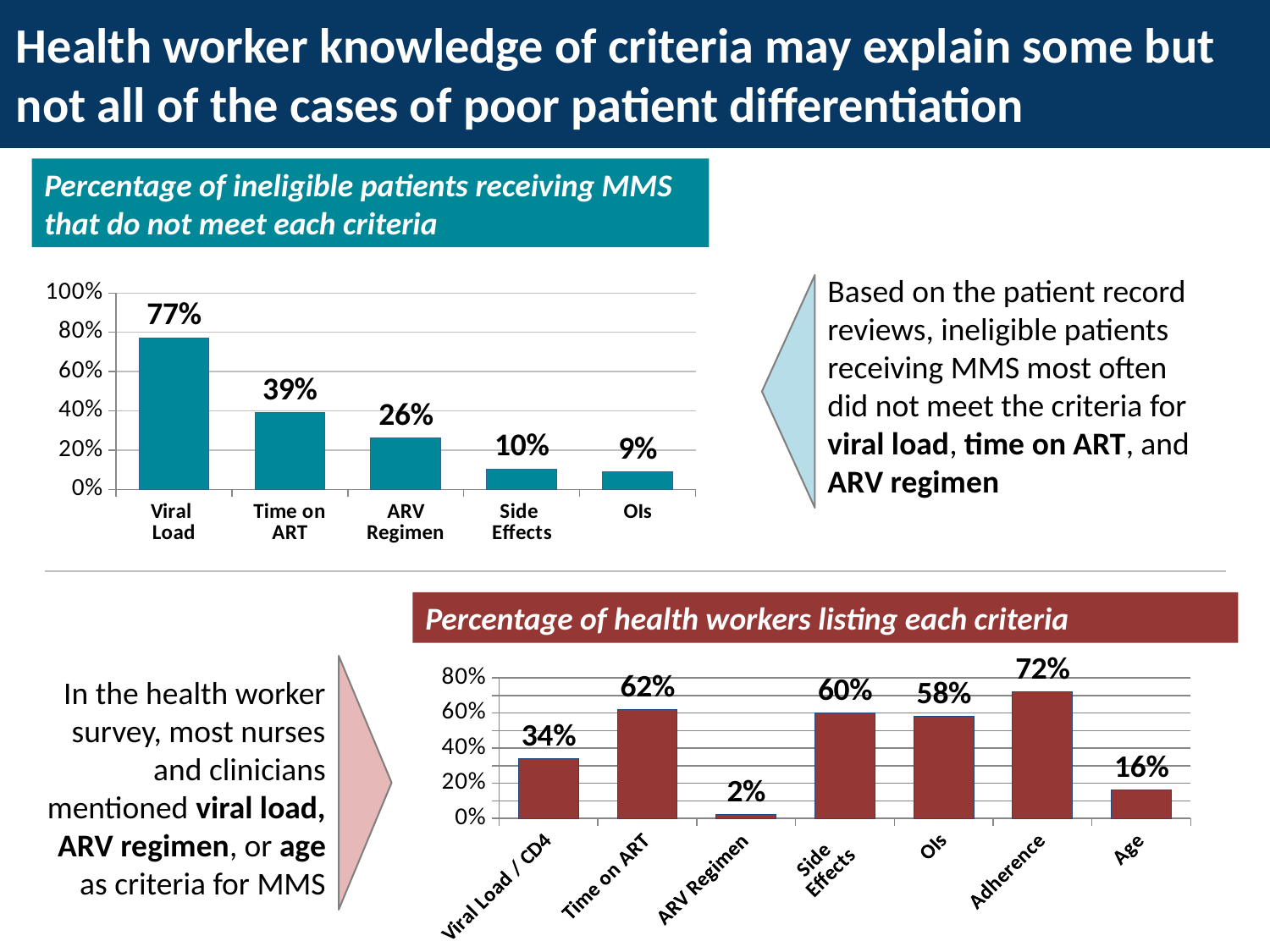
In the chart 'Percentage of ineligible patients receiving MMS that do not meet each criteria', what is the difference between Time on ART and ARV Regimen? 13% In the chart 'Percentage of health workers listing each criteria', what is the value for Adherence? 72% In the chart 'Percentage of health workers listing each criteria', what is the difference between Viral Load / CD4 and Age? 18% In the chart 'Percentage of health workers listing each criteria', which category has the lowest value? ARV Regimen In the chart 'Percentage of ineligible patients receiving MMS that do not meet each criteria', how many categories are shown? 5 In the chart 'Percentage of ineligible patients receiving MMS that do not meet each criteria', do the values rise or fall from left to right? fall In the chart 'Percentage of health workers listing each criteria', which category has the highest value? Adherence In the chart 'Percentage of ineligible patients receiving MMS that do not meet each criteria', which category has the lowest value? OIs In the chart 'Percentage of ineligible patients receiving MMS that do not meet each criteria', what is the value for Viral Load? 77% In the chart 'Percentage of health workers listing each criteria', how many categories are shown? 7 In the chart 'Percentage of health workers listing each criteria', which is larger, Time on ART or Side Effects? Time on ART What kind of chart is the 'Percentage of health workers listing each criteria' chart? bar chart